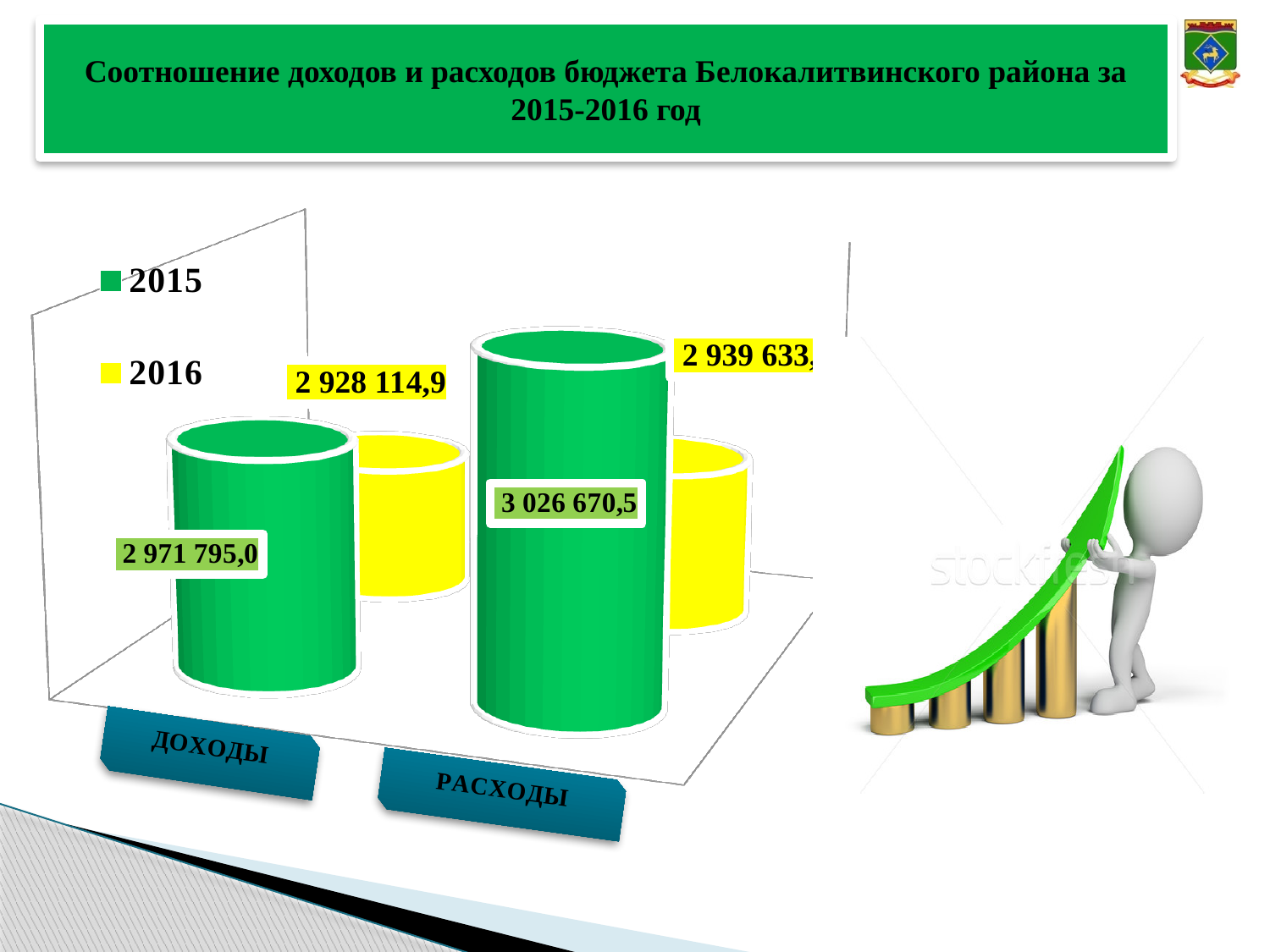
How many categories are shown on the chart? 2 How many series does the legend list? 2 What is the title of the slide? Соотношение доходов и расходов бюджета Белокалитвинского района за 2015-2016 год In 2015, which is larger: ДОХОДЫ or РАСХОДЫ? РАСХОДЫ What is the difference between РАСХОДЫ and ДОХОДЫ in 2015? 54 875,5 What colour represents the 2015 series in the legend? green Which bar on the chart is the highest? РАСХОДЫ 2015 What is the value for РАСХОДЫ in 2015? 3 026 670,5 What is the difference between ДОХОДЫ in 2015 and ДОХОДЫ in 2016? 43 680,1 What kind of chart is shown on the slide? bar chart What is the value for ДОХОДЫ in 2015? 2 971 795,0 What is the value for ДОХОДЫ in 2016? 2 928 114,9